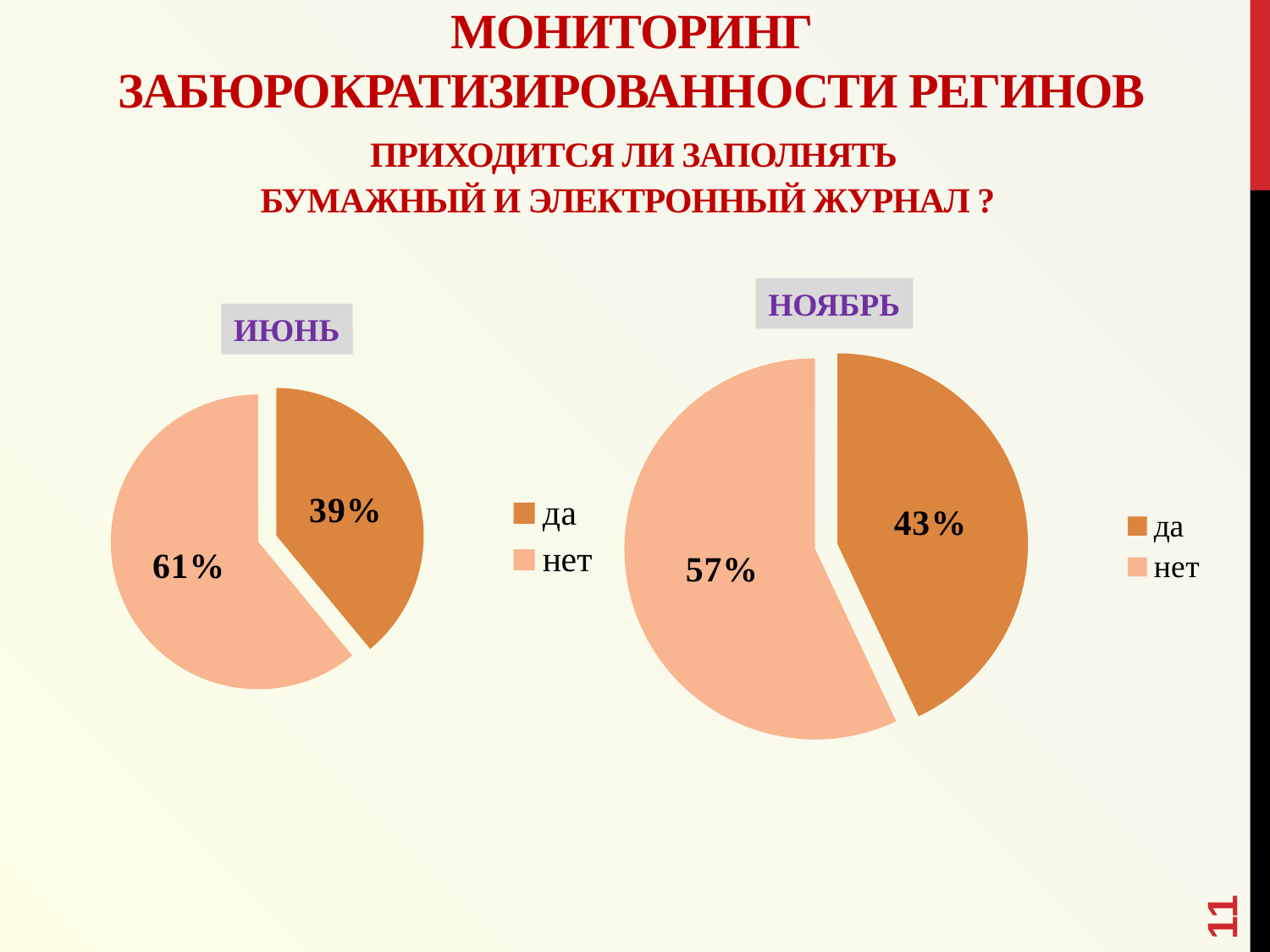
In the НОЯБРЬ pie chart, which slice is the smallest? да How many entries does the legend of the ИЮНЬ chart list? 2 In the НОЯБРЬ pie chart, what share is labelled for "да"? 43% In the ИЮНЬ pie chart, which slice is the largest? нет In the НОЯБРЬ pie chart, what share is labelled for "нет"? 57% In the ИЮНЬ pie chart, what is the difference between the "нет" and "да" shares? 22% In the ИЮНЬ pie chart, what share is labelled for "нет"? 61% How many slices does the НОЯБРЬ pie chart have? 2 What kind of chart is the ИЮНЬ chart? Pie chart In the НОЯБРЬ pie chart, what is the difference between the "нет" and "да" shares? 14% Which chart has the larger "да" share, ИЮНЬ or НОЯБРЬ? НОЯБРЬ In the ИЮНЬ pie chart, what share is labelled for "да"? 39%